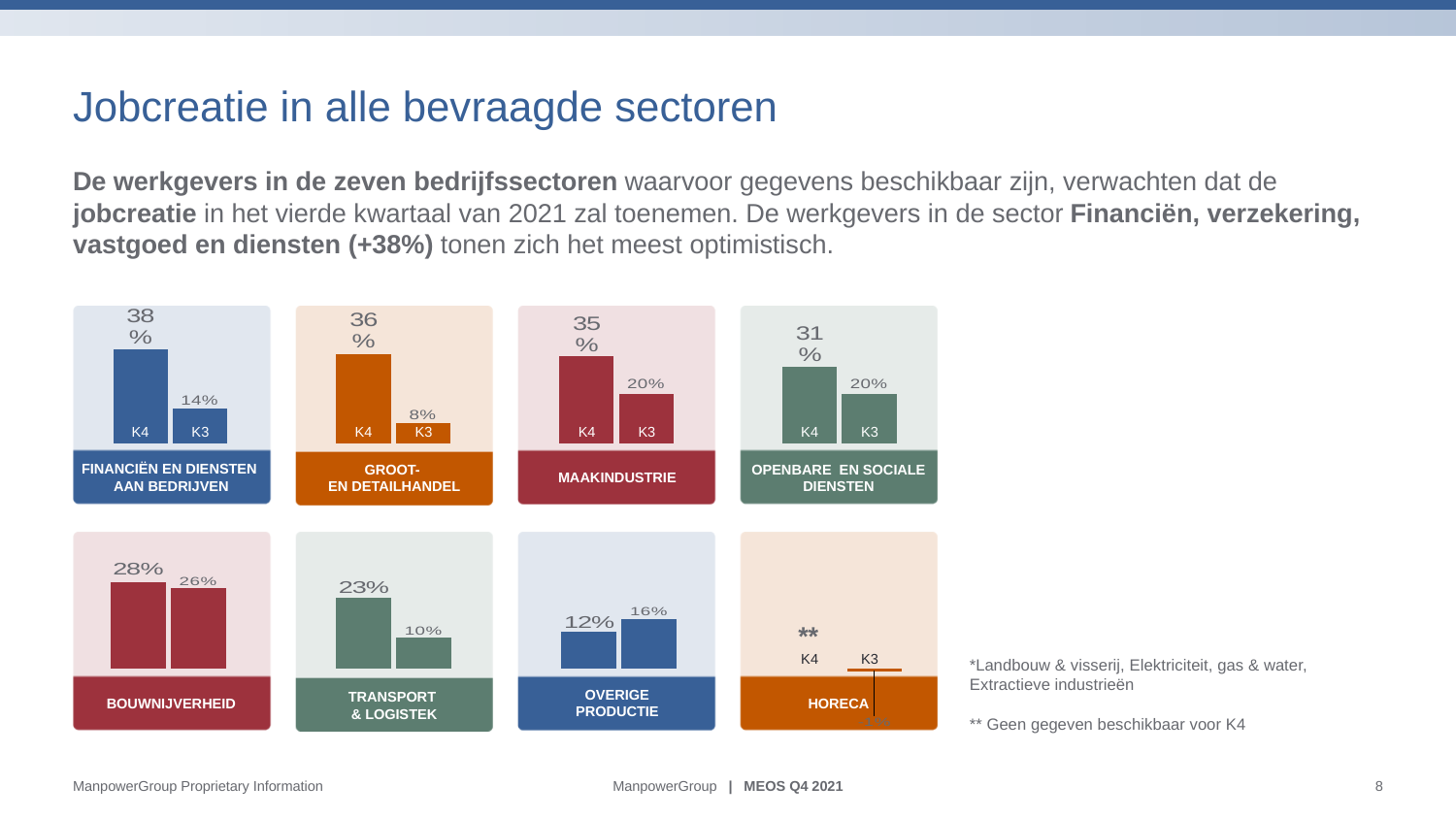
What kind of chart is used for the Maakindustrie sector? Bar chart In the Groot- en detailhandel chart, how many bars are plotted? 2 In the Horeca chart, which quarter has no data available, as marked by the asterisks? K4 In the Bouwnijverheid chart, what is the difference between the K4 and K3 values? 2% In the Financiën en diensten aan bedrijven chart, what is the difference between the K4 and K3 values? 24% In the Maakindustrie chart, what is the value for K3? 20% In the Transport & logistiek chart, which is larger, K4 or K3? K4 In the Openbare en sociale diensten chart, what is the value for K4? 31% In the Groot- en detailhandel chart, what is the value for K3? 8% In the Overige productie chart, which is larger, K4 or K3? K3 Across all the sector charts, which sector has the highest K4 value? Financiën en diensten aan bedrijven In the Financiën en diensten aan bedrijven chart, what is the value for K4? 38%